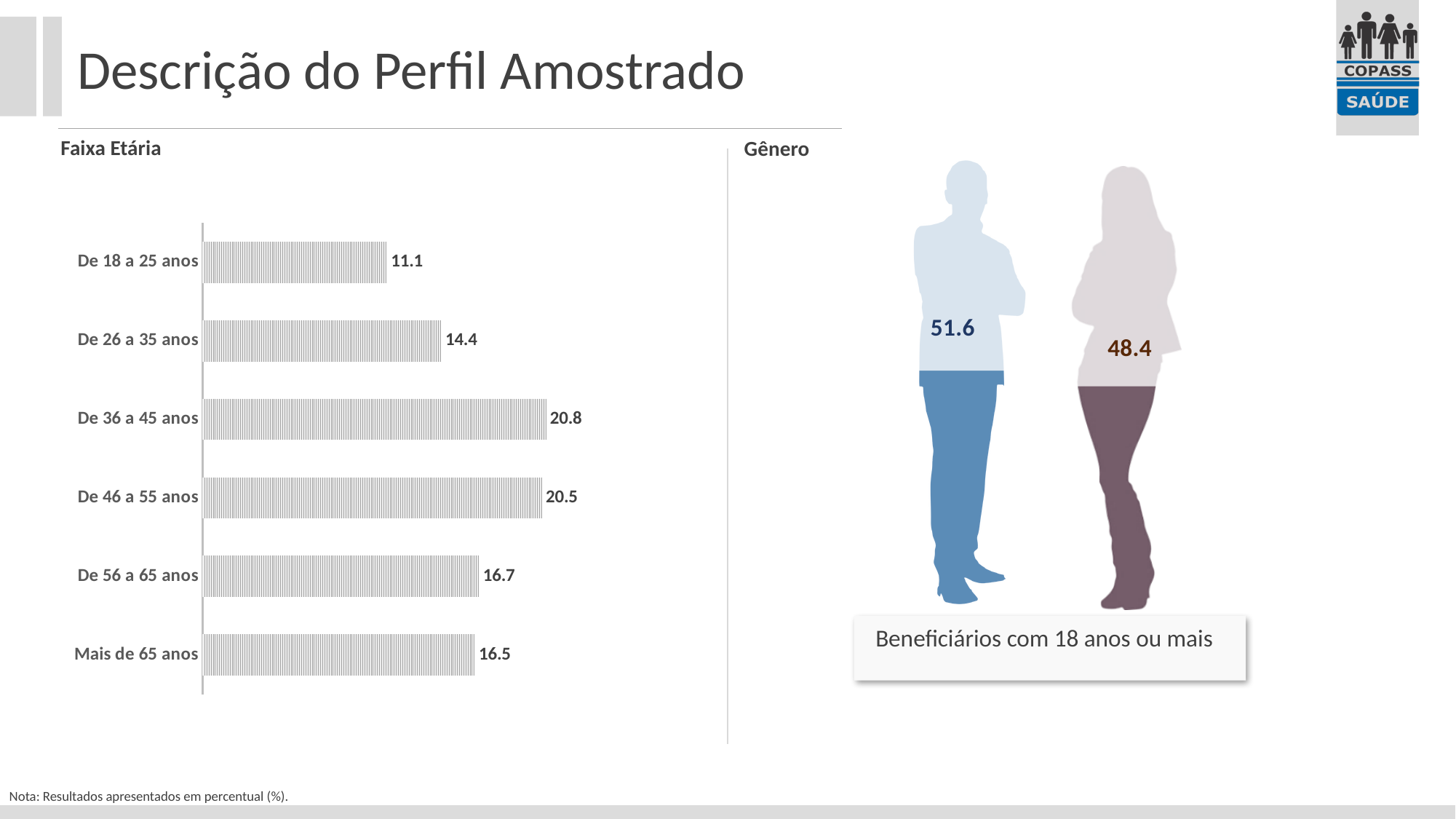
In the Faixa Etária chart, which age group has the lowest value? De 18 a 25 anos In the Faixa Etária chart, which is larger: the value for De 26 a 35 anos or the value for De 56 a 65 anos? De 56 a 65 anos In the Faixa Etária chart, do the values rise or fall from De 18 a 25 anos to De 36 a 45 anos? Rise In the Faixa Etária chart, what is the value for De 18 a 25 anos? 11.1 In the Gênero figure, what is the value shown for the male silhouette? 51.6 What kind of chart is the Faixa Etária chart? Bar chart In the Faixa Etária chart, what is the difference between the values for De 36 a 45 anos and De 18 a 25 anos? 9.7 In the Faixa Etária chart, what is the difference between the values for De 56 a 65 anos and Mais de 65 anos? 0.2 How many age groups are shown in the Faixa Etária chart? 6 In the Faixa Etária chart, what is the value for Mais de 65 anos? 16.5 In the Faixa Etária chart, which age group has the highest value? De 36 a 45 anos In the Faixa Etária chart, what is the value for De 36 a 45 anos? 20.8